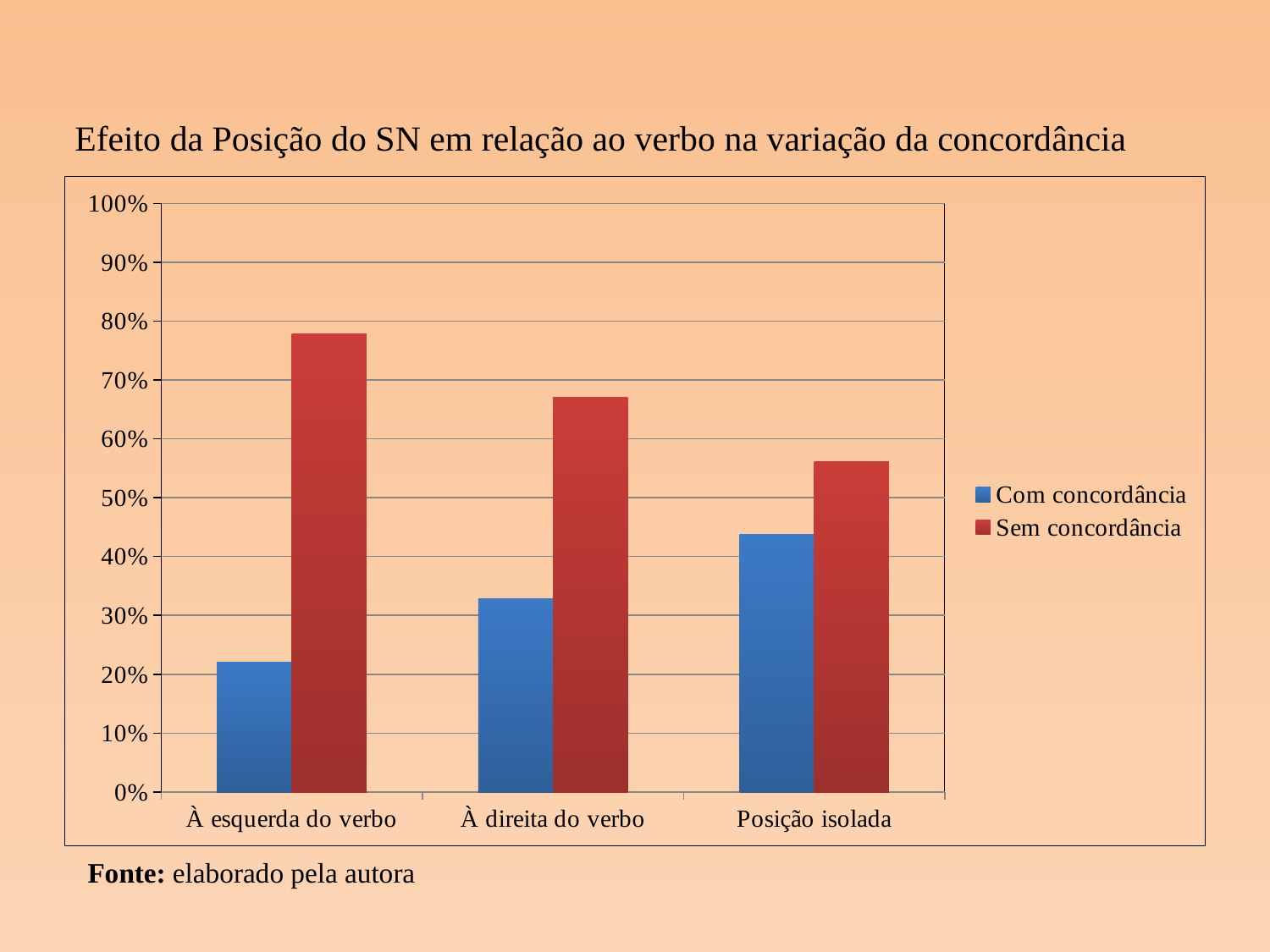
Which category has the highest value for Sem concordância? À esquerda do verbo Is the value for Com concordância at Posição isolada greater or less than 50%? less Do the values for Com concordância rise or fall from À esquerda do verbo to Posição isolada? rise How many series does the legend list? 2 How many categories are shown on the x axis? 3 What kind of chart is shown on the slide? bar chart Is the value for Com concordância at À esquerda do verbo greater or less than 30%? less Is the value for Sem concordância at À esquerda do verbo greater or less than 70%? greater Which category has the lowest value for Com concordância? À esquerda do verbo For Posição isolada, which is larger: Com concordância or Sem concordância? Sem concordância Which category has the highest value for Com concordância? Posição isolada